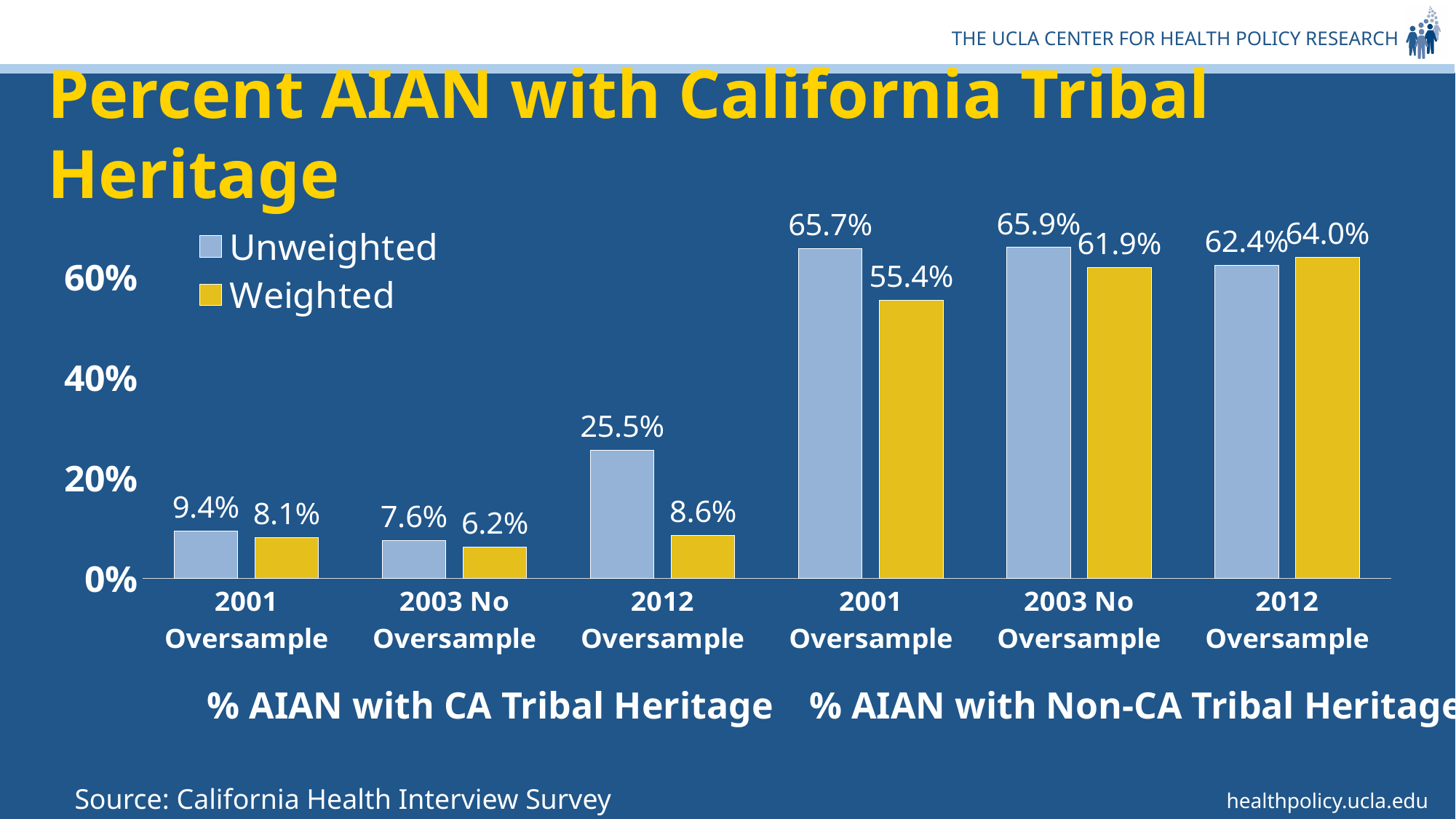
What is the Weighted value for 2001 Oversample in the % AIAN with Non-CA Tribal Heritage group? 55.4% For 2012 Oversample in the % AIAN with Non-CA Tribal Heritage group, which is larger, the Unweighted or the Weighted value? Weighted What is the Unweighted value for 2012 Oversample in the % AIAN with CA Tribal Heritage group? 25.5% What is the difference between the Unweighted and Weighted values for 2012 Oversample in the % AIAN with CA Tribal Heritage group? 16.9% How many series does the legend list? 2 Which category has the highest Unweighted value? 2003 No Oversample (% AIAN with Non-CA Tribal Heritage) Is the Weighted value for 2003 No Oversample in the % AIAN with Non-CA Tribal Heritage group greater or less than 60%? greater What is the difference between the Unweighted and Weighted values for 2001 Oversample in the % AIAN with Non-CA Tribal Heritage group? 10.3% What is the title of the chart? Percent AIAN with California Tribal Heritage What is the Weighted value for 2003 No Oversample in the % AIAN with CA Tribal Heritage group? 6.2% What kind of chart is shown on the slide? Bar chart Which category has the lowest Weighted value? 2003 No Oversample (% AIAN with CA Tribal Heritage)